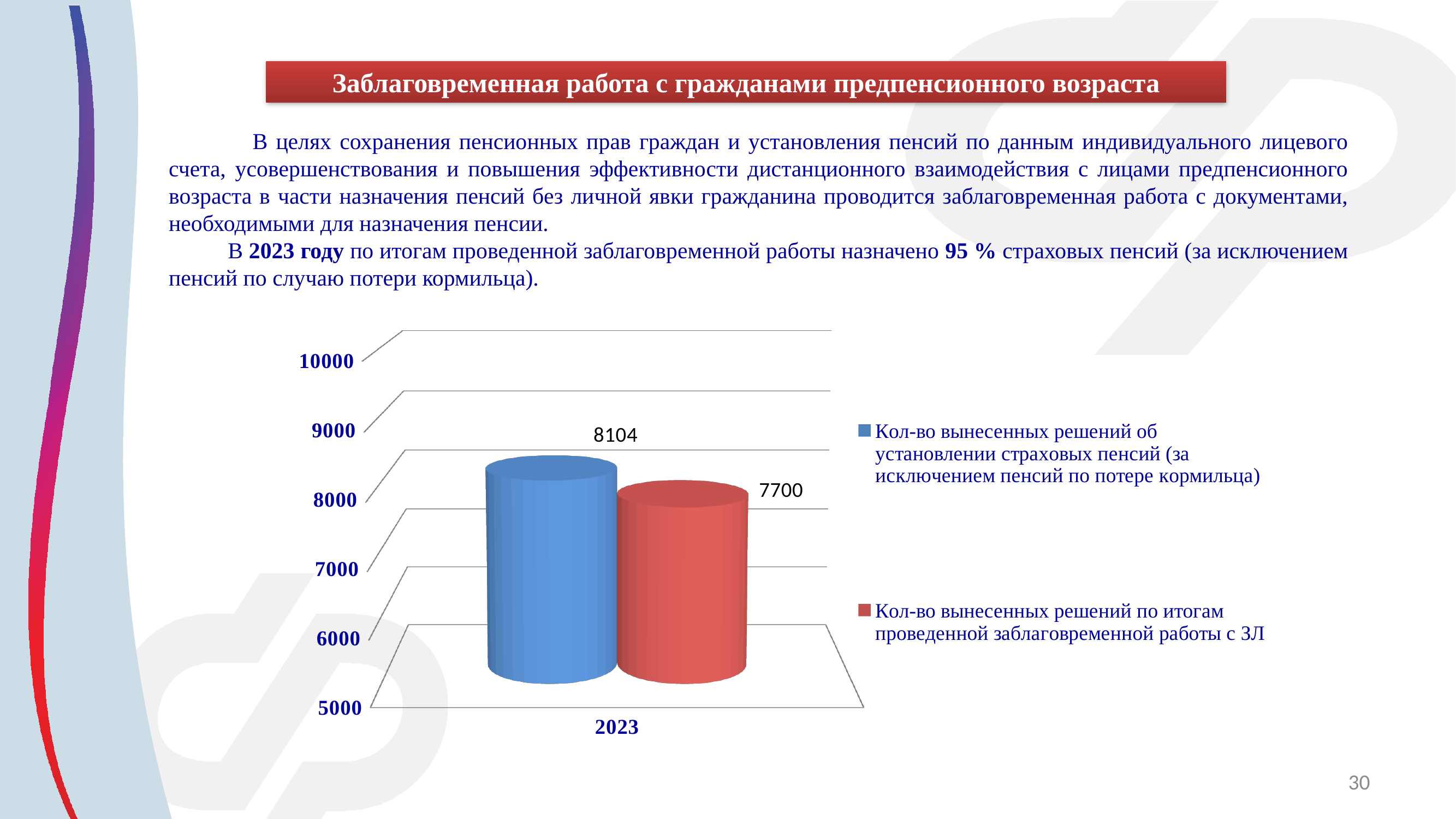
How many series does the legend list? 2 Is the value for the blue series greater or less than 8000? greater Which year is shown on the x axis of the chart? 2023 What kind of chart is shown on the slide? Bar chart Is the value for the red series greater or less than 8000? less Which series has the lowest value in the chart? Кол-во вынесенных решений по итогам проведенной заблаговременной работы с ЗЛ What is the value of the red series (Кол-во вынесенных решений по итогам проведенной заблаговременной работы с ЗЛ) for 2023? 7700 What colour represents the series 'Кол-во вынесенных решений по итогам проведенной заблаговременной работы с ЗЛ'? Red What is the difference between the two values shown for 2023? 404 What is the value of the blue series (Кол-во вынесенных решений об установлении страховых пенсий) for 2023? 8104 Which series has the higher value in 2023: the blue one or the red one? The blue one (Кол-во вынесенных решений об установлении страховых пенсий) How many categories are shown on the x axis? 1